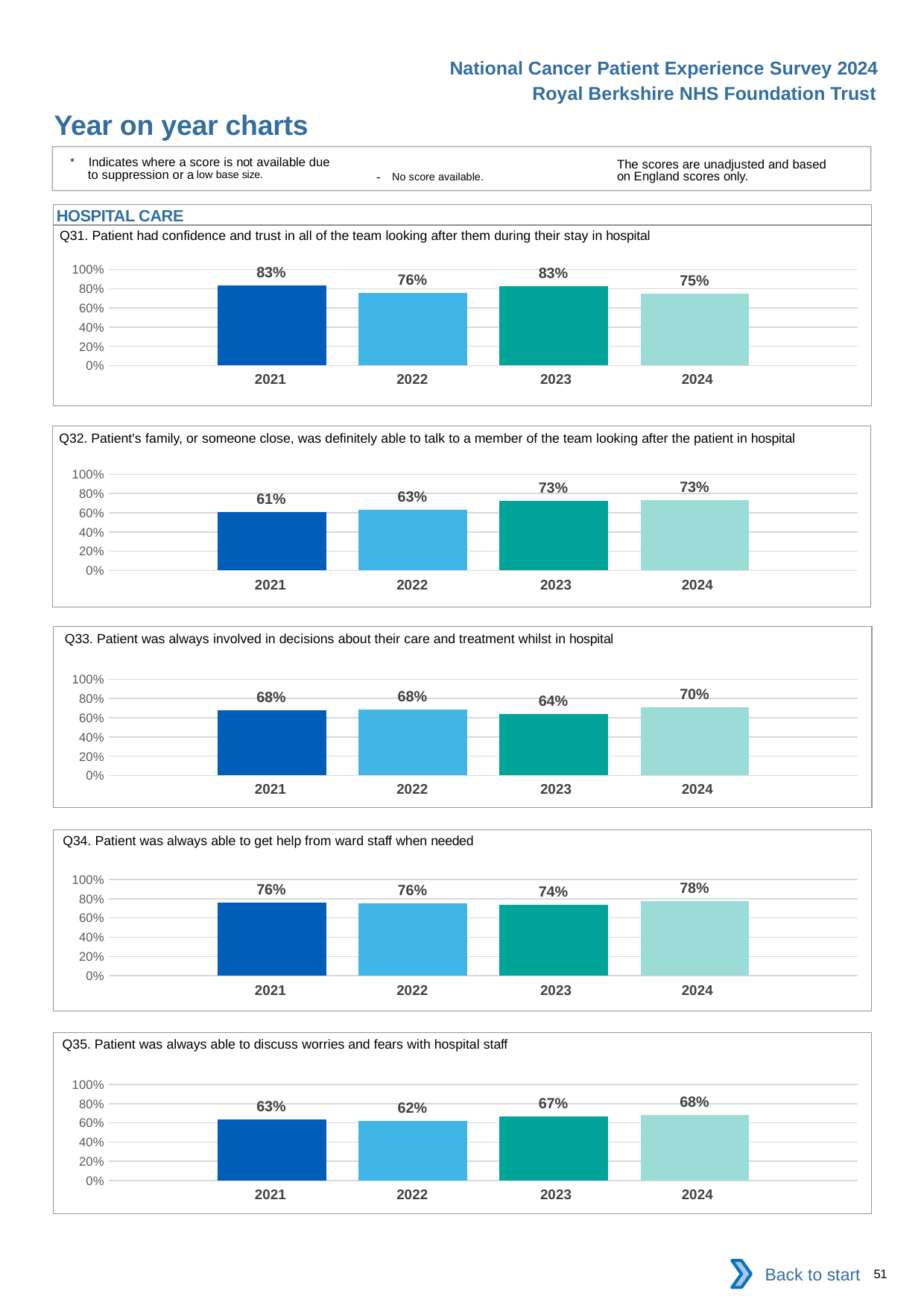
In the Q32 chart, what is the difference between the 2023 value and the 2021 value? 12% In the Q31 chart, what is the value for 2024? 75% In the Q35 chart, is the value for 2023 larger or smaller than the value for 2022? larger In the Q35 chart, what is the value for 2021? 63% In the Q34 chart, is the value for 2023 greater or less than 60%? greater What type of chart is the Q33 chart? bar chart In the Q33 chart, what is the difference between the 2024 value and the 2023 value? 6% What is the section heading shown above the Q31 chart? HOSPITAL CARE How many bars are plotted in the Q32 chart? 4 In the Q32 chart, which year has the lowest value? 2021 In the Q34 chart, which year has the highest value? 2024 In the Q31 chart, what is the value for 2022? 76%